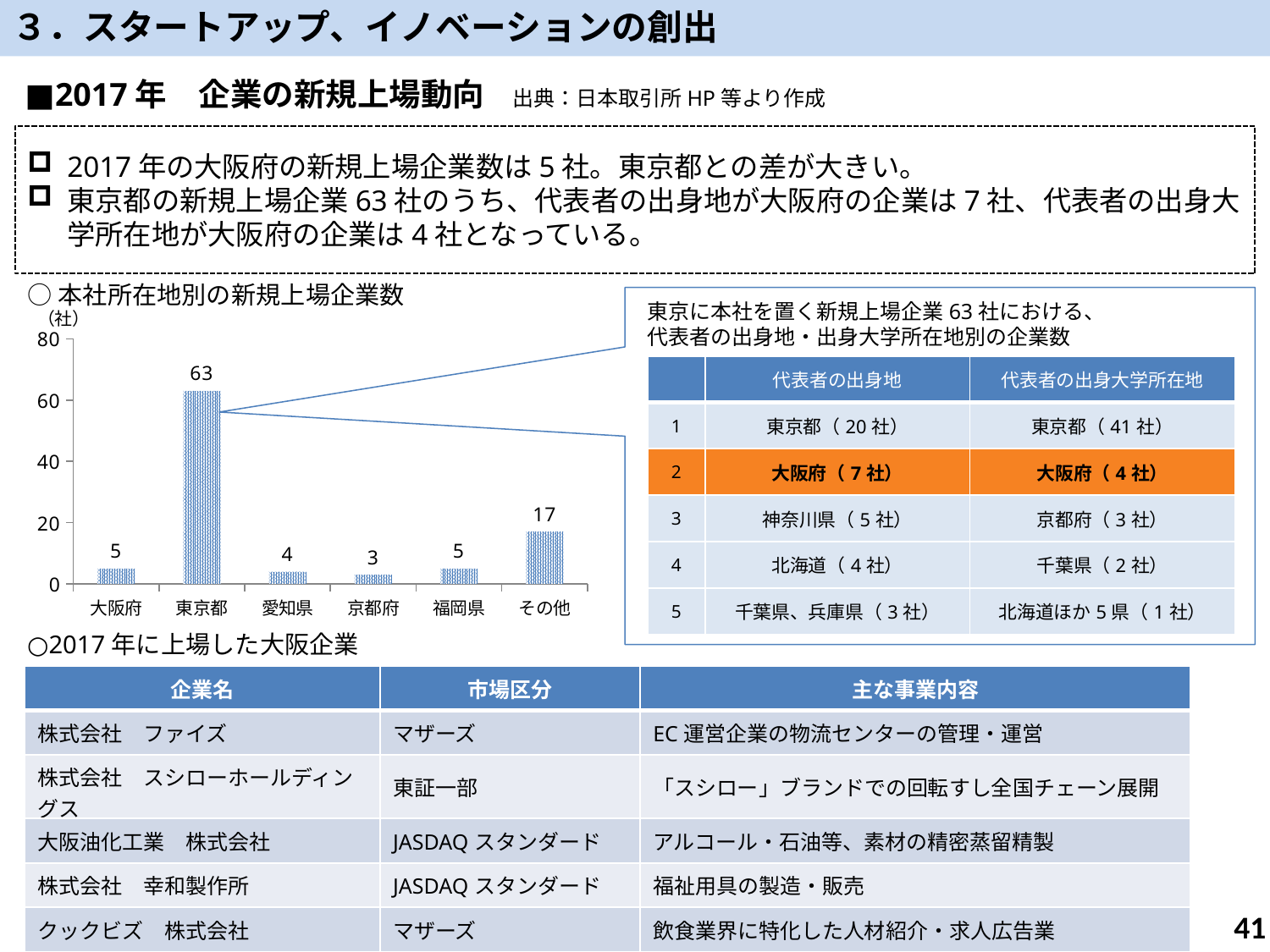
What is the value for 東京都 in the 本社所在地別の新規上場企業数 chart? 63 In the 本社所在地別の新規上場企業数 chart, which is larger, the value for 愛知県 or the value for 京都府? 愛知県 What is the value for その他 in the 本社所在地別の新規上場企業数 chart? 17 What kind of chart is the 本社所在地別の新規上場企業数 chart? bar chart Which category has the lowest value in the 本社所在地別の新規上場企業数 chart? 京都府 How many categories are shown on the x axis of the 本社所在地別の新規上場企業数 chart? 6 What is the difference between the values for その他 and 福岡県 in the 本社所在地別の新規上場企業数 chart? 12 What unit is shown at the top of the y axis of the 本社所在地別の新規上場企業数 chart? （社） What is the difference between the values for 東京都 and 大阪府 in the 本社所在地別の新規上場企業数 chart? 58 Which category has the highest value in the 本社所在地別の新規上場企業数 chart? 東京都 What is the value for 大阪府 in the 本社所在地別の新規上場企業数 chart? 5 What is the value for 愛知県 in the 本社所在地別の新規上場企業数 chart? 4